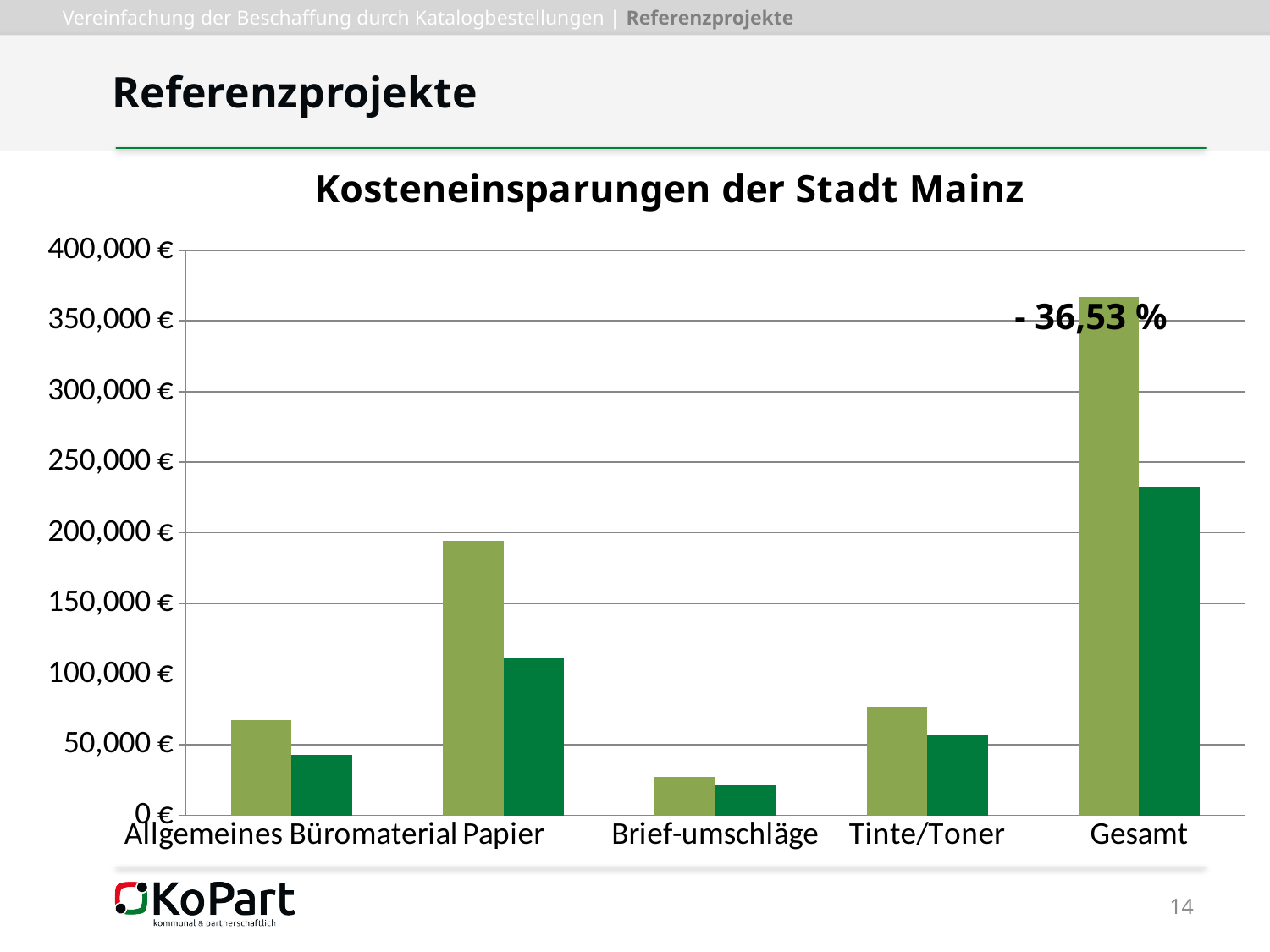
Which category has a taller light green bar, Papier or Tinte/Toner? Papier Which category has the shortest bars in the chart? Brief-umschläge What kind of chart is shown on the slide? bar chart Which category has the tallest bars in the chart? Gesamt Is the dark green bar for Gesamt greater or less than 250,000 €? less Is the light green bar for Papier greater or less than 150,000 €? greater What is the title of the chart? Kosteneinsparungen der Stadt Mainz What percentage annotation is printed next to the Gesamt bars? - 36,53 % Is the light green bar for Gesamt greater or less than 350,000 €? greater How many categories are shown on the x axis of the chart? 5